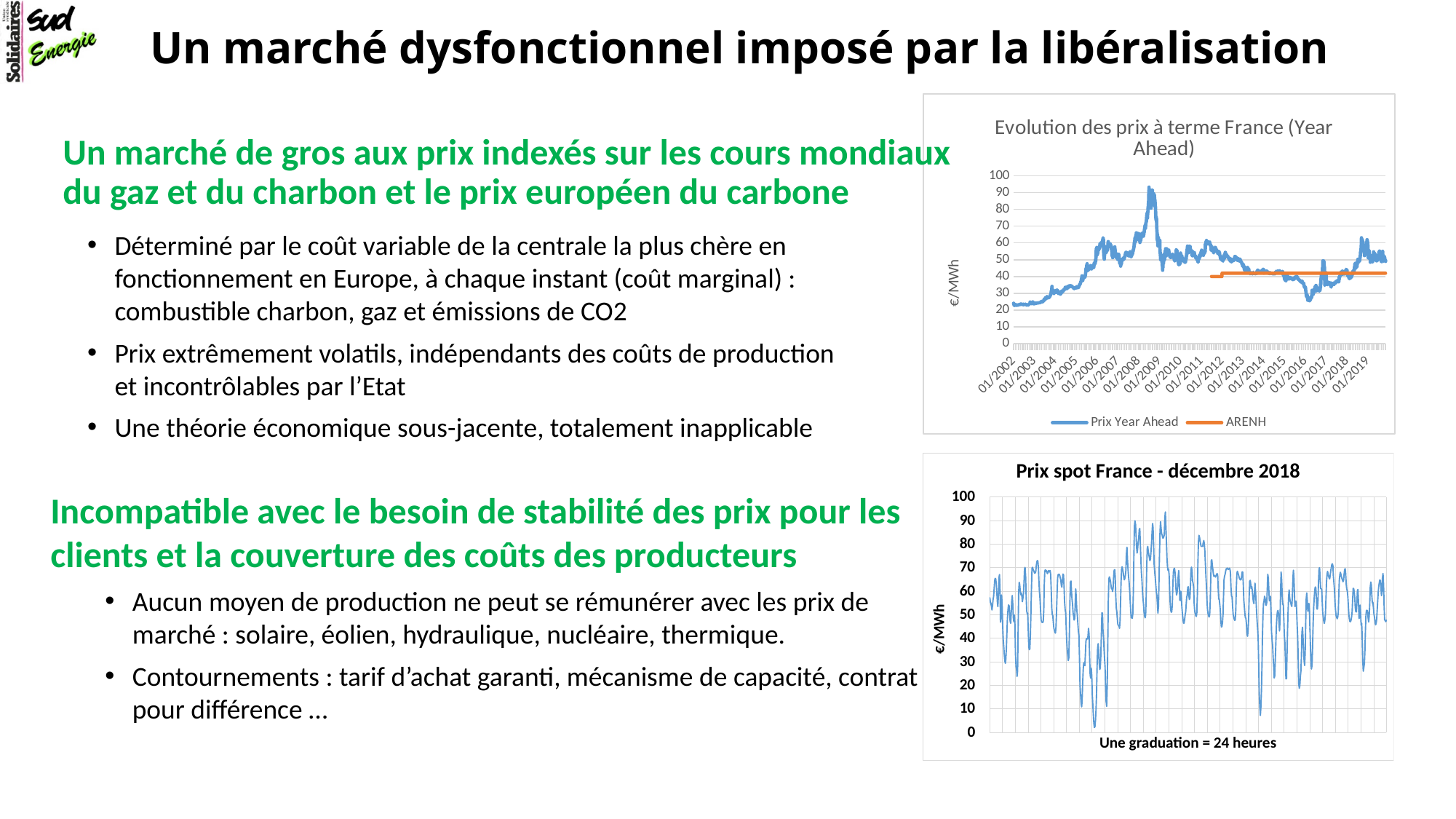
In the 'Prix spot France - décembre 2018' chart, is the lowest value reached greater or less than 10? less In the 'Evolution des prix à terme France (Year Ahead)' chart, is the Prix Year Ahead value at 01/2002 greater or less than 30? less How many series does the legend of the 'Evolution des prix à terme France (Year Ahead)' chart list? 2 In the 'Evolution des prix à terme France (Year Ahead)' chart, what are the two series named in the legend? Prix Year Ahead and ARENH What kind of chart is the 'Evolution des prix à terme France (Year Ahead)' chart? line chart In the 'Evolution des prix à terme France (Year Ahead)' chart, is the peak value of Prix Year Ahead around 01/2009 greater or less than 80? greater In the 'Evolution des prix à terme France (Year Ahead)' chart, does the Prix Year Ahead series generally rise or fall between 01/2002 and 01/2009? rise In the 'Evolution des prix à terme France (Year Ahead)' chart, which series is drawn in orange? ARENH What is the y-axis unit label on the 'Prix spot France - décembre 2018' chart? €/MWh What kind of chart is the 'Prix spot France - décembre 2018' chart? line chart